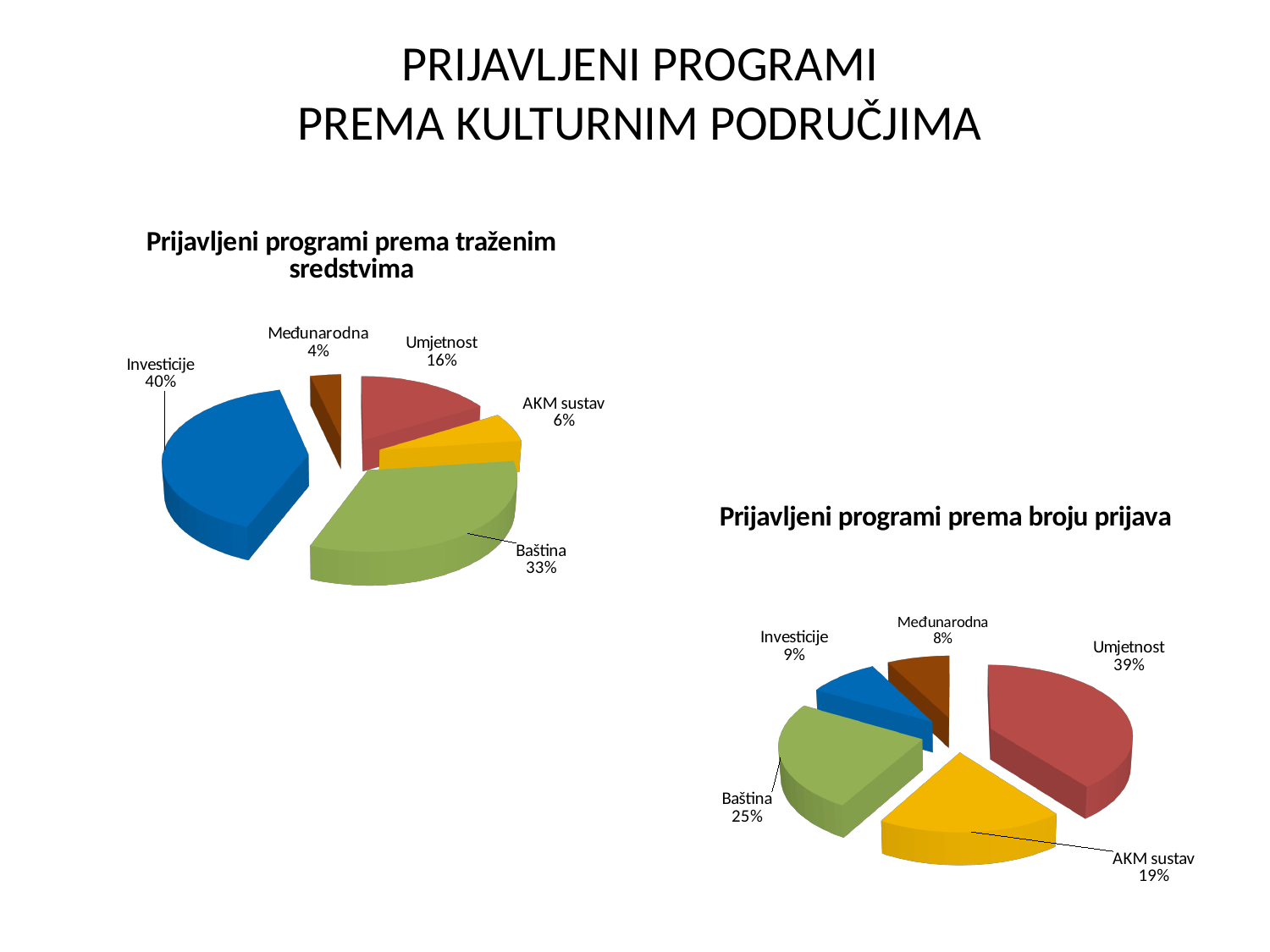
In the chart 'Prijavljeni programi prema broju prijava', what share does Umjetnost have? 39% In the chart 'Prijavljeni programi prema traženim sredstvima', what share does Investicije have? 40% In the chart 'Prijavljeni programi prema broju prijava', which category has the largest share? Umjetnost In the chart 'Prijavljeni programi prema broju prijava', what is the difference between the shares of Baština and Međunarodna? 17% How many categories does the chart 'Prijavljeni programi prema broju prijava' show? 5 What type of chart is 'Prijavljeni programi prema traženim sredstvima'? Pie chart In the chart 'Prijavljeni programi prema traženim sredstvima', what share does Baština have? 33% In the chart 'Prijavljeni programi prema traženim sredstvima', which category has the smallest share? Međunarodna In the chart 'Prijavljeni programi prema broju prijava', which is larger, Baština or Investicije? Baština In the chart 'Prijavljeni programi prema broju prijava', what share does AKM sustav have? 19% In the chart 'Prijavljeni programi prema traženim sredstvima', which category has the largest share? Investicije In the chart 'Prijavljeni programi prema traženim sredstvima', what is the difference between the shares of Umjetnost and AKM sustav? 10%